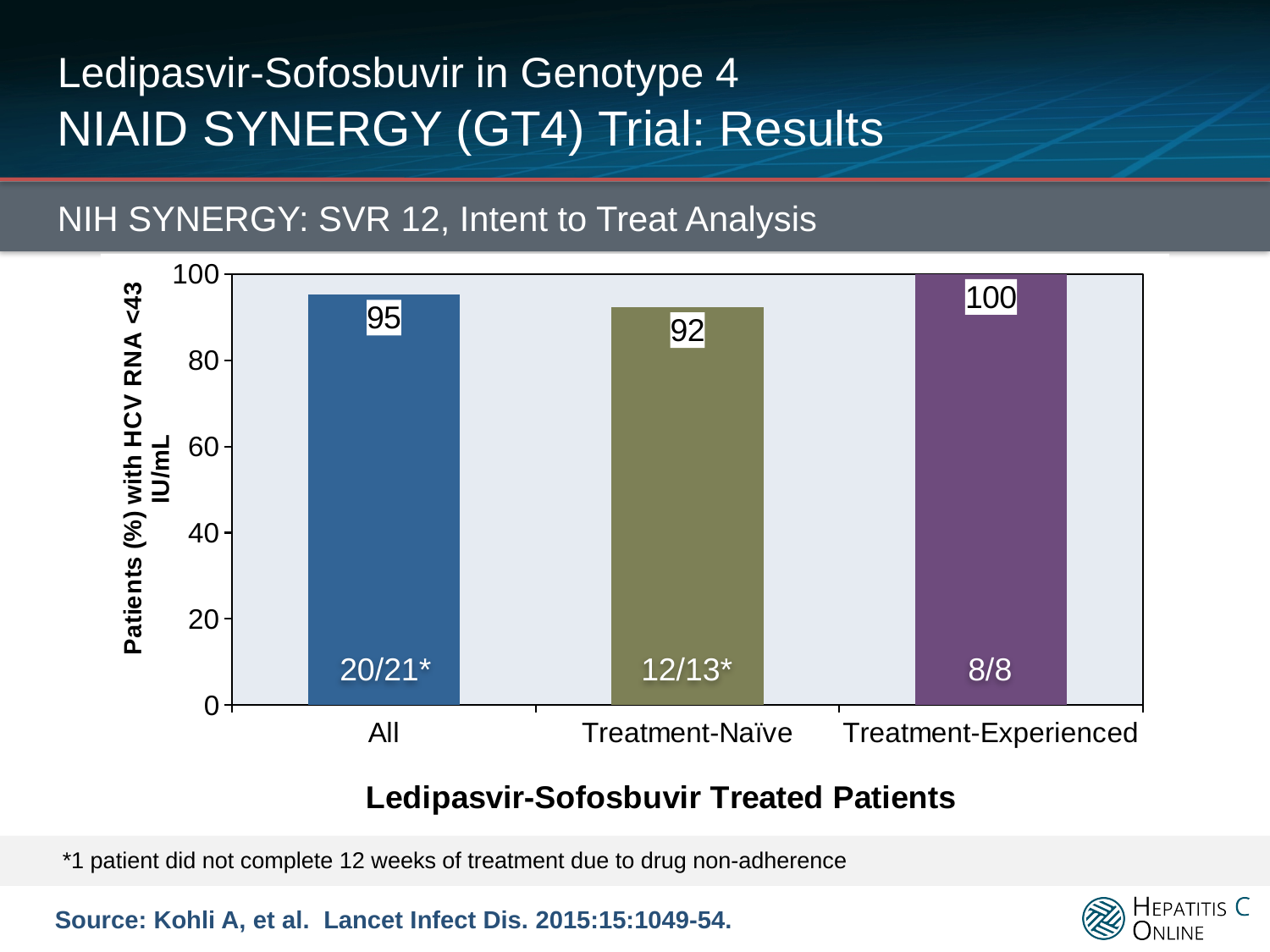
What is the difference between the Treatment-Experienced and Treatment-Naïve values? 8 Which group has the lowest SVR 12 value? Treatment-Naïve What is the SVR 12 value for Treatment-Experienced patients? 100 What is the SVR 12 value for the All group? 95 Which is larger, the value for All or the value for Treatment-Naïve? All Which group has the highest SVR 12 value? Treatment-Experienced What is the difference between the All value and the Treatment-Naïve value? 3 What fraction of patients is printed on the Treatment-Experienced bar? 8/8 What is the x-axis title of the chart? Ledipasvir-Sofosbuvir Treated Patients How many patient groups are shown in the chart? 3 What kind of chart is shown on the slide? Bar chart What is the SVR 12 value for Treatment-Naïve patients? 92